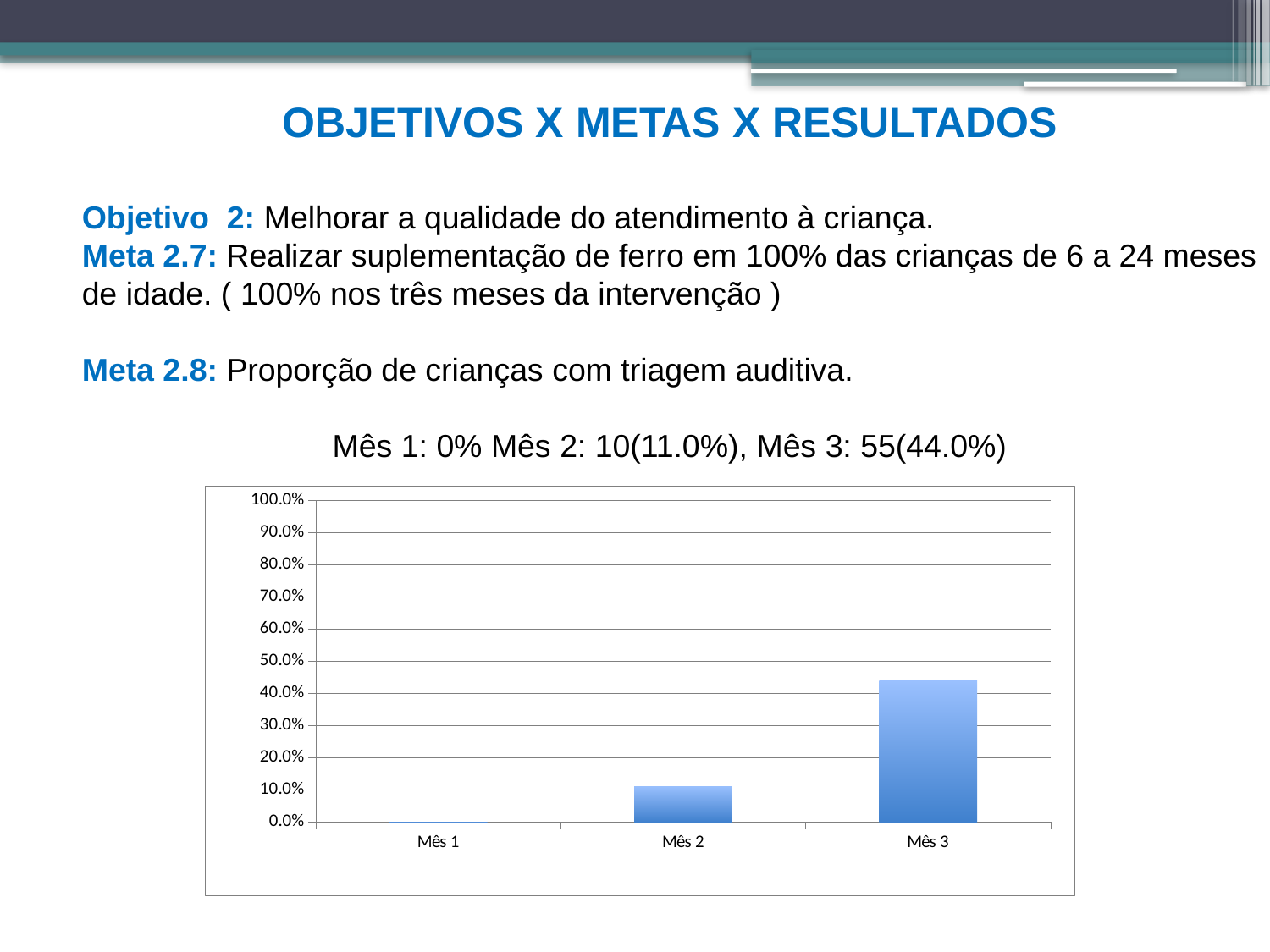
What is the difference between the values for Mês 3 and Mês 2? 33.0% What is the value for Mês 3 in the chart? 44.0% Which month has the highest value in the chart? Mês 3 What is the value for Mês 2 in the chart? 11.0% Which is larger, the value for Mês 2 or the value for Mês 3? Mês 3 Is the value for Mês 2 greater or less than 20.0%? less Which month has the lowest value in the chart? Mês 1 What is the value for Mês 1 in the chart? 0.0% How many categories are plotted on the x axis of the chart? 3 Do the values rise or fall from Mês 1 to Mês 3? rise Is the value for Mês 3 greater or less than 40.0%? greater What kind of chart is shown on the slide? bar chart